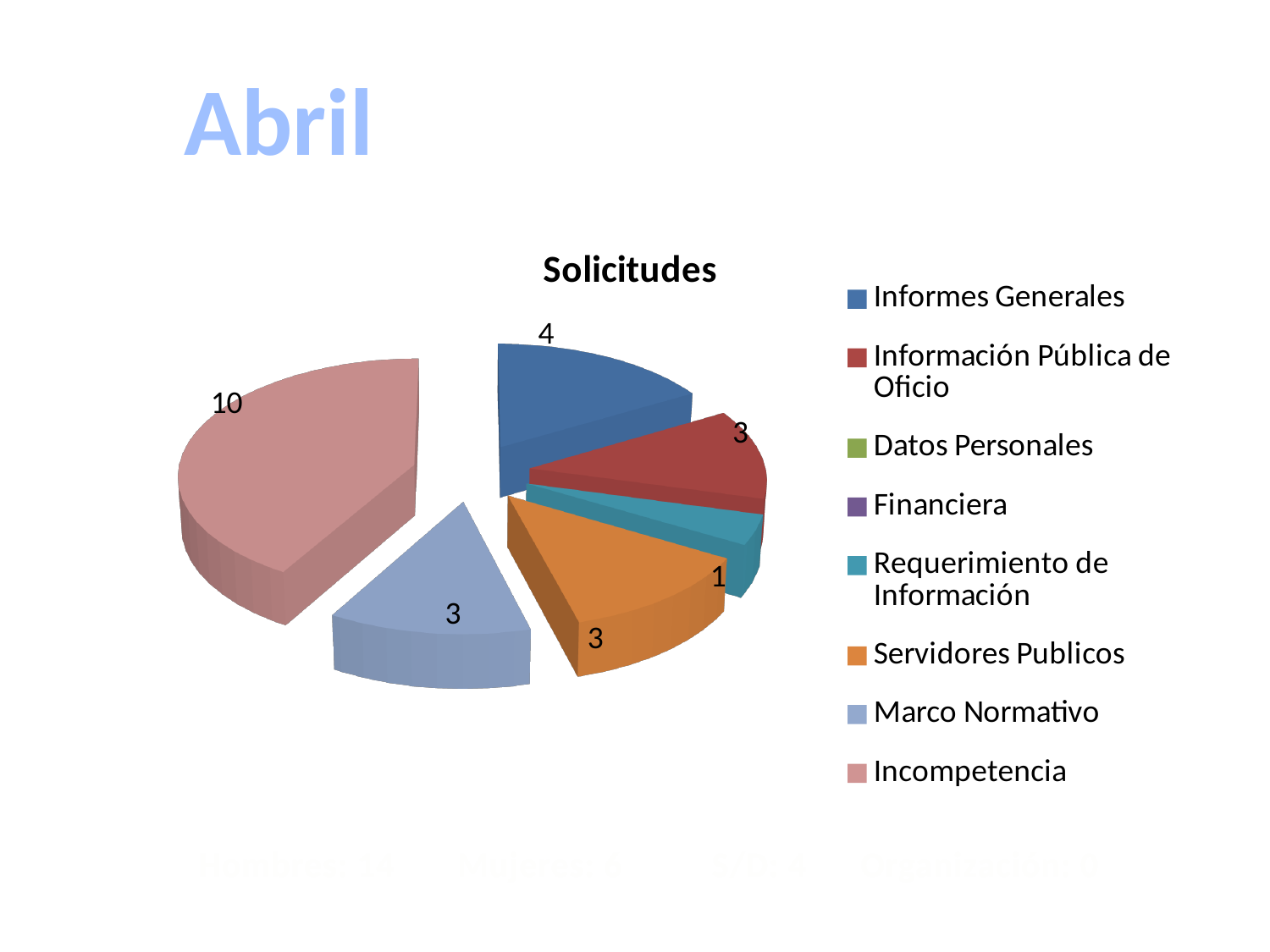
What is the value for Servidores Publicos? 3 Which category has the largest slice? Incompetencia Which is larger, the value for Informes Generales or the value for Marco Normativo? Informes Generales What is the value for Requerimiento de Información? 1 What is the difference between the values for Incompetencia and Informes Generales? 6 What is the value for Incompetencia? 10 How many entries does the legend list? 8 What kind of chart is shown on the slide? pie chart What is the value for Marco Normativo? 3 Which labeled slice has the smallest value? Requerimiento de Información What is the value for Informes Generales? 4 What is the title of the chart? Solicitudes